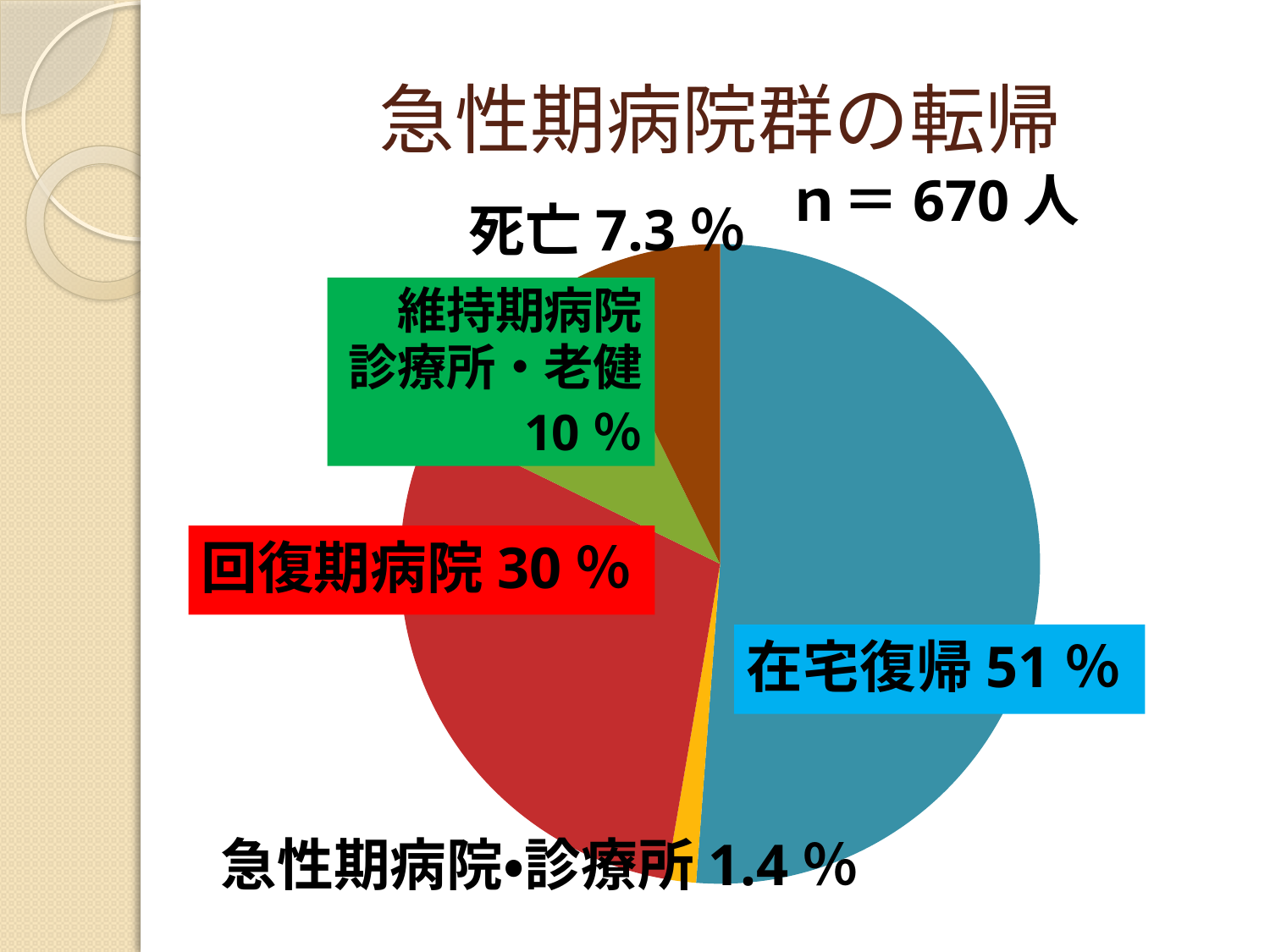
What share of the pie is 維持期病院 診療所・老健? 10 % What kind of chart is shown on the slide? pie chart What is the difference in percentage points between 在宅復帰 and 回復期病院? 21 What is the sample size (n) shown on the slide? 670 人 What share of the pie is 回復期病院? 30 % Which category has the smallest share of the pie? 急性期病院•診療所 What share of the pie is 在宅復帰? 51 % Which category has the largest share of the pie? 在宅復帰 What is the title of the chart? 急性期病院群の転帰 How many slices does the pie chart have? 5